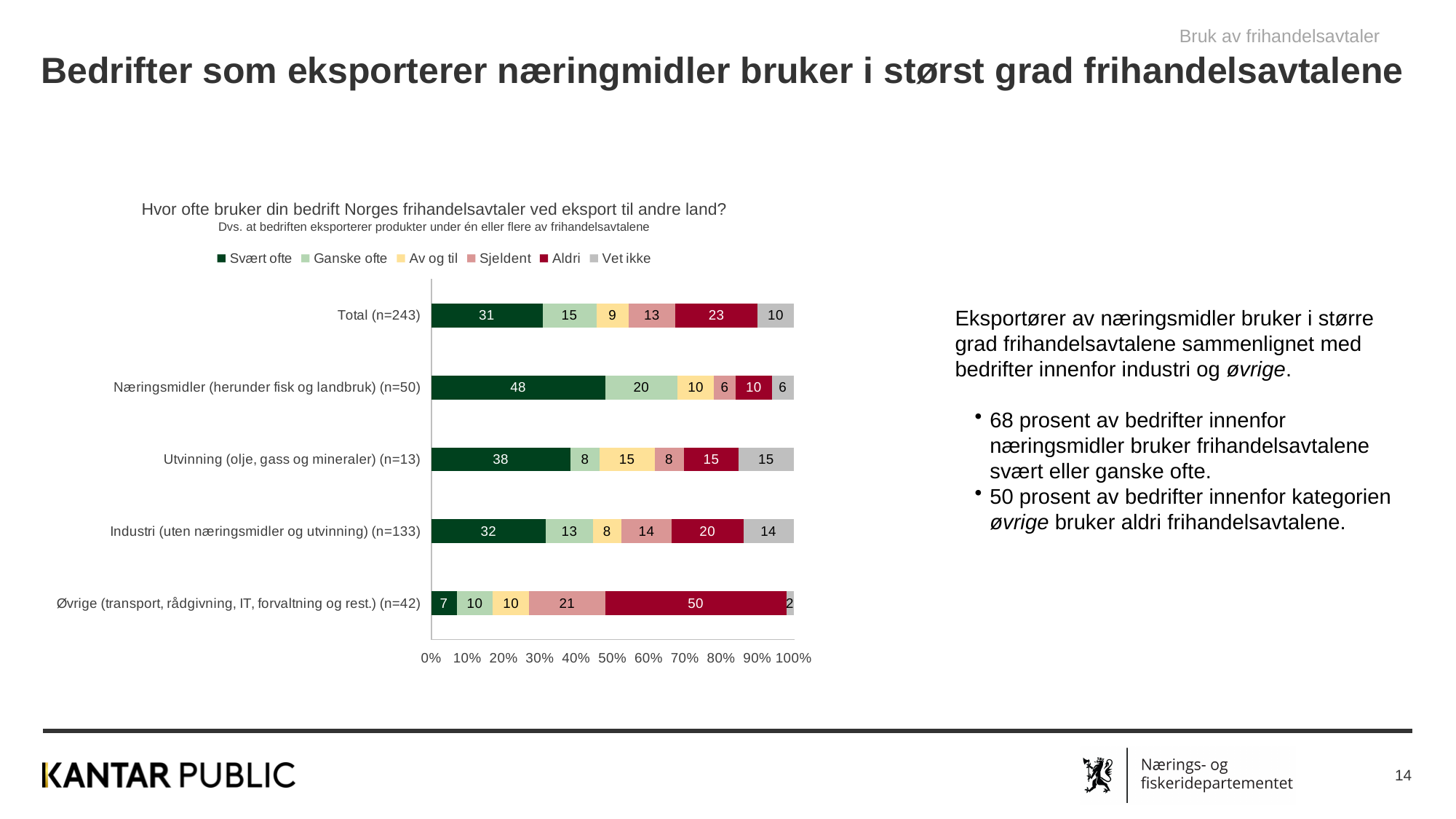
What is the 'Vet ikke' value for Utvinning (olje, gass og mineraler) (n=13)? 15 What is the 'Svært ofte' value for Næringsmidler (herunder fisk og landbruk) (n=50)? 48 What is the 'Aldri' value for Øvrige (transport, rådgivning, IT, forvaltning og rest.) (n=42)? 50 Which is larger: the 'Ganske ofte' value for Total (n=243) or for Industri (n=133)? Total (n=243) How many series does the legend list? 6 Which category has the lowest 'Aldri' value? Næringsmidler (herunder fisk og landbruk) (n=50) What type of chart is shown on the slide? Stacked bar chart Which category has the highest 'Svært ofte' value? Næringsmidler (herunder fisk og landbruk) (n=50) What is the difference between the 'Aldri' values for Øvrige (n=42) and Industri (n=133)? 30 What is the 'Sjeldent' value for Total (n=243)? 13 What is the combined 'Svært ofte' and 'Ganske ofte' value for Næringsmidler (herunder fisk og landbruk) (n=50)? 68 How many categories (bars) are shown in the chart? 5